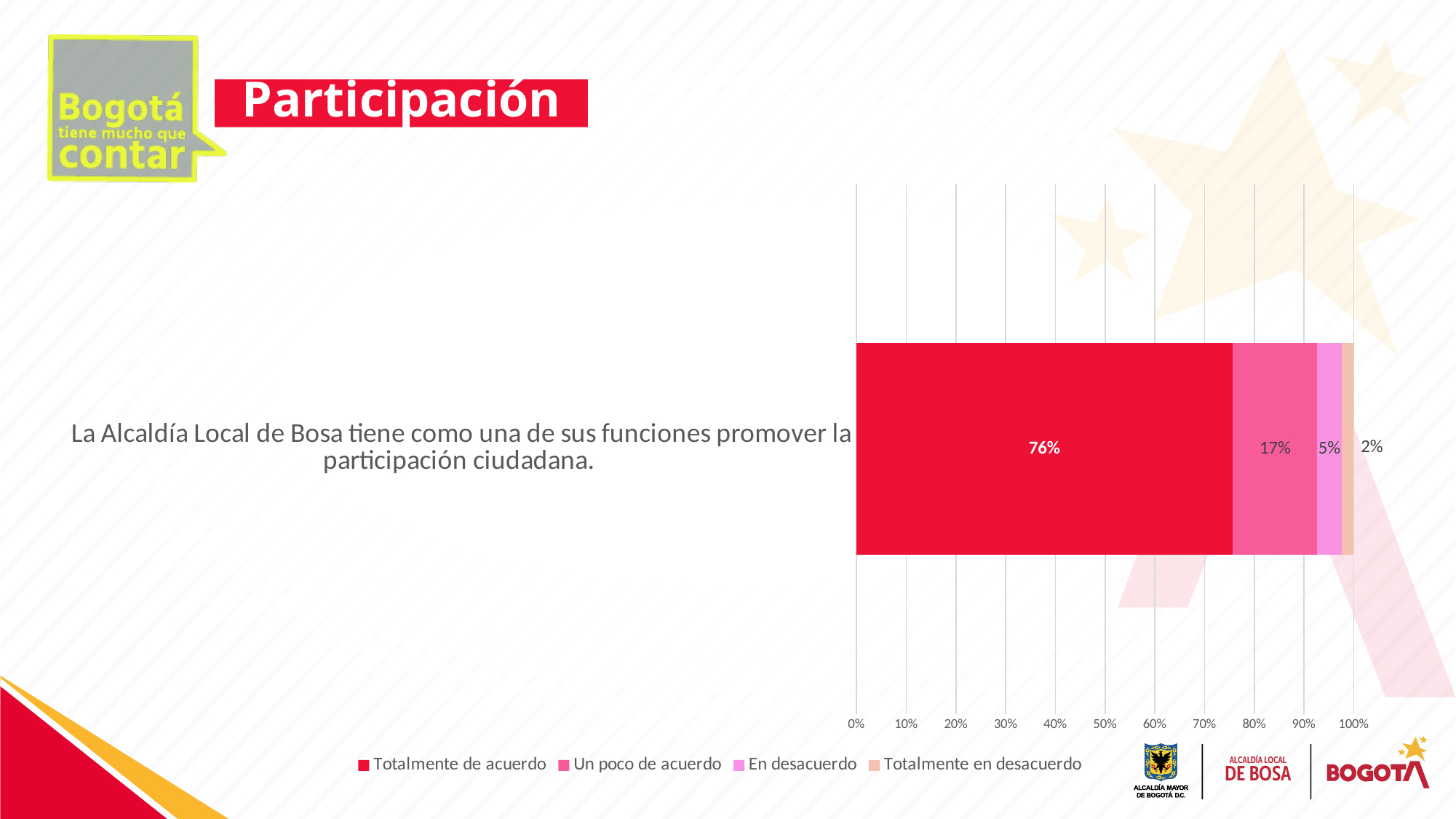
What is the difference between the "Totalmente de acuerdo" and "Un poco de acuerdo" shares? 59% What percentage of respondents answered "Totalmente de acuerdo"? 76% What percentage of respondents answered "Totalmente en desacuerdo"? 2% What is the combined share of "Totalmente de acuerdo" and "Un poco de acuerdo"? 93% What percentage of respondents answered "En desacuerdo"? 5% Is the value for "Totalmente de acuerdo" greater or less than 70%? greater Which response option has the smallest share? Totalmente en desacuerdo Which is larger, the share for "En desacuerdo" or for "Totalmente en desacuerdo"? En desacuerdo Which response option has the largest share? Totalmente de acuerdo How many series does the legend list? 4 What percentage of respondents answered "Un poco de acuerdo"? 17% What kind of chart is shown on the slide? Stacked bar chart